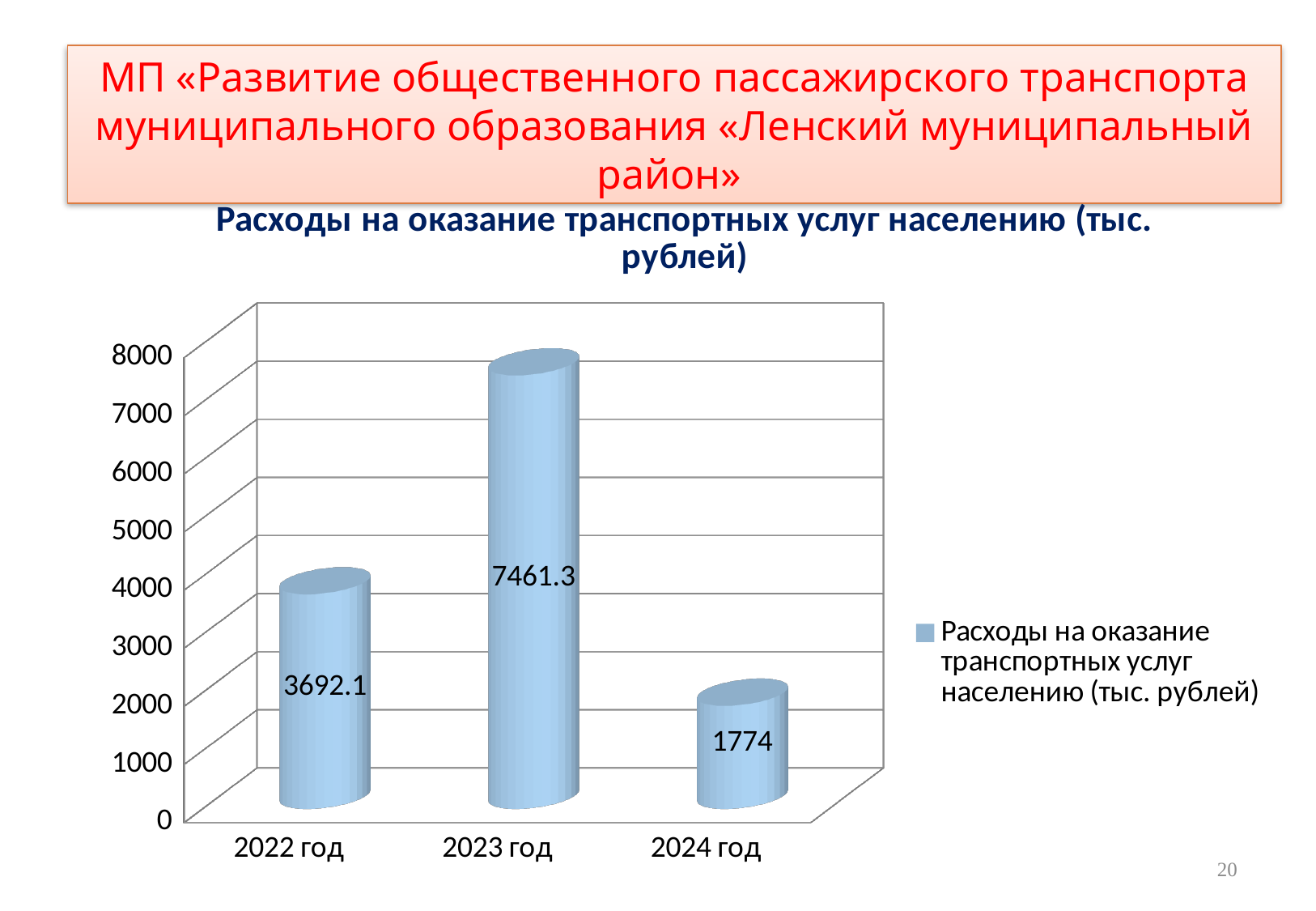
What is the title of the chart? Расходы на оказание транспортных услуг населению (тыс. рублей) How many series does the legend list? 1 What is the difference between the values for 2022 год and 2024 год? 1918.1 How many years are shown on the x axis? 3 What is the value for 2024 год? 1774 Which is larger, the value for 2022 год or the value for 2024 год? 2022 год What kind of chart is shown on the slide? bar chart What is the difference between the values for 2023 год and 2022 год? 3769.2 What is the value for 2023 год? 7461.3 Which year has the highest value? 2023 год Which year has the lowest value? 2024 год What is the value for 2022 год? 3692.1